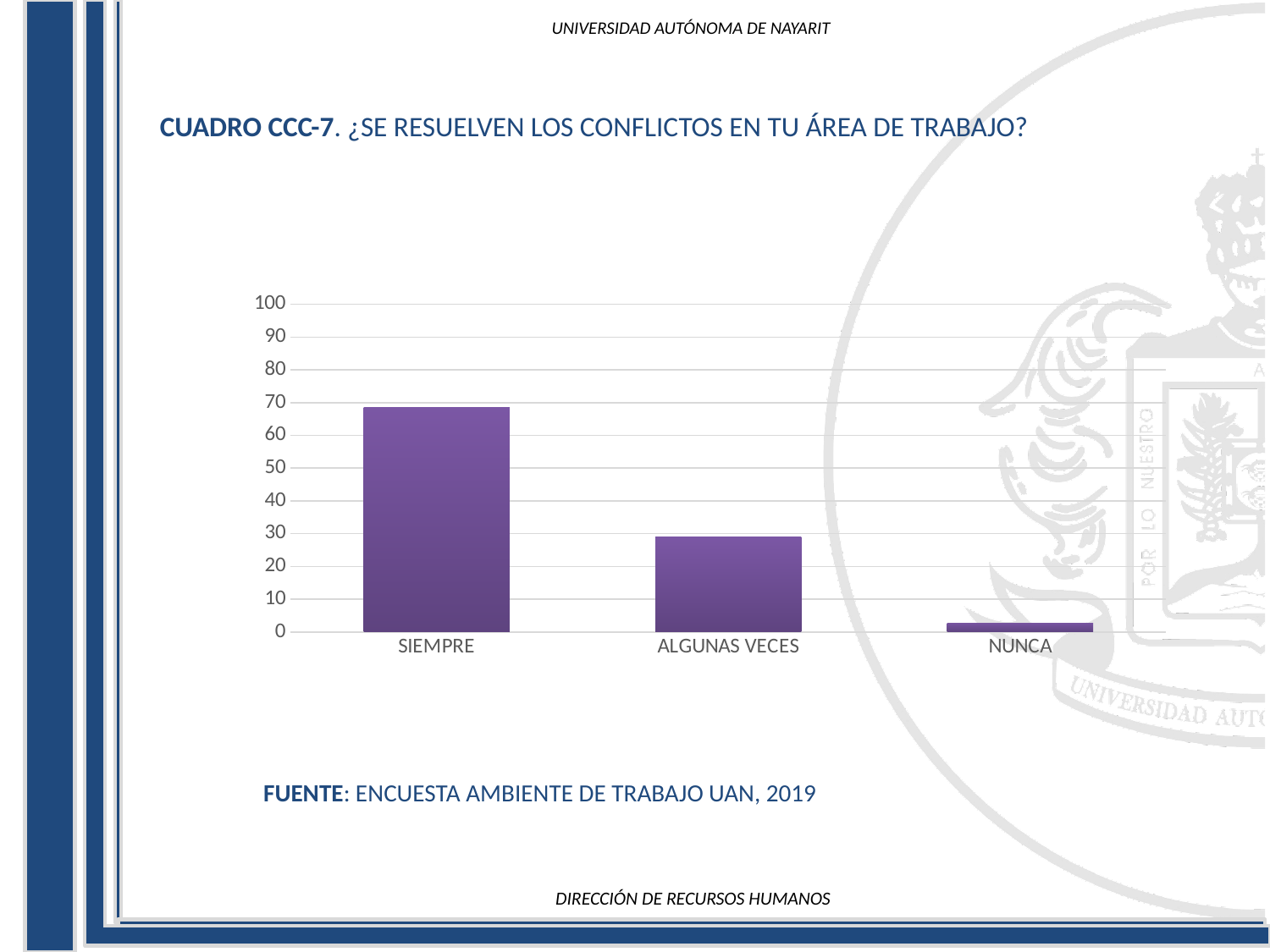
What kind of chart is shown on the slide? bar chart Which category has the lowest value? NUNCA Which is larger, the value for SIEMPRE or the value for ALGUNAS VECES? SIEMPRE Which category has the highest value? SIEMPRE Is the value for ALGUNAS VECES greater or less than 20? greater How many categories are shown on the x axis? 3 Is the value for ALGUNAS VECES greater or less than 40? less Is the value for NUNCA greater or less than 10? less Which is larger, the value for ALGUNAS VECES or the value for NUNCA? ALGUNAS VECES Do the values rise or fall from left to right along the x axis? fall